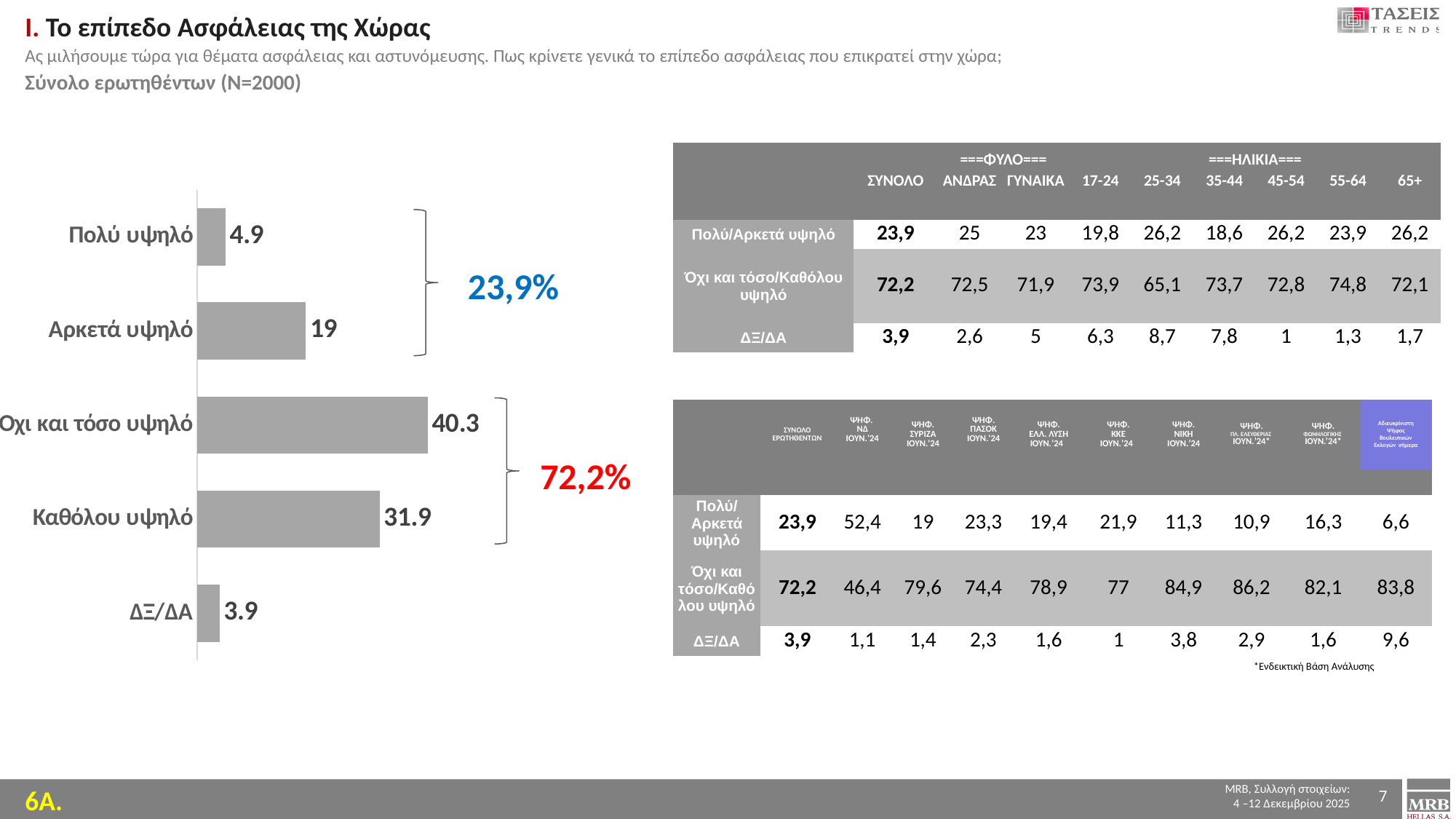
What combined percentage is shown next to the bracket grouping "Όχι και τόσο υψηλό" and "Καθόλου υψηλό" in the bar chart? 72,2% Which is larger in the bar chart: the value for "Αρκετά υψηλό" or the value for "Πολύ υψηλό"? Αρκετά υψηλό What is the value for "Καθόλου υψηλό" in the bar chart? 31.9 Which category has the lowest value in the bar chart? ΔΞ/ΔΑ What is the difference between the values for "Όχι και τόσο υψηλό" and "Καθόλου υψηλό" in the bar chart? 8.4 What is the value for "Αρκετά υψηλό" in the bar chart? 19 What is the value for "Όχι και τόσο υψηλό" in the bar chart? 40.3 Which category has the highest value in the bar chart? Όχι και τόσο υψηλό What is the value for "Πολύ υψηλό" in the bar chart? 4.9 What is the value for "ΔΞ/ΔΑ" in the bar chart? 3.9 How many categories are shown in the bar chart? 5 What kind of chart is shown on the left of the slide? Bar chart